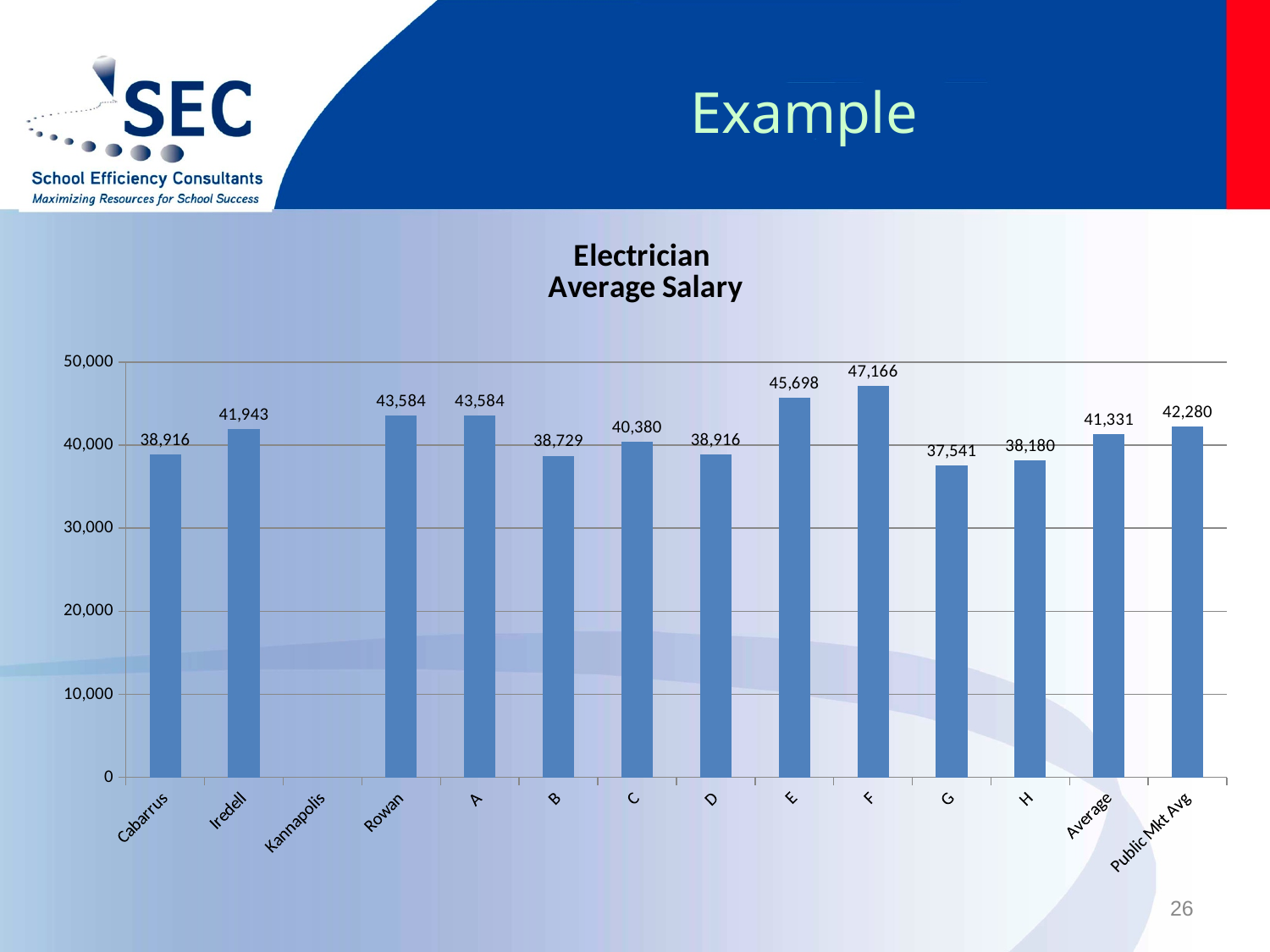
Which is larger, the value for Iredell or the value for Cabarrus? Iredell How many category labels appear on the x axis? 14 What kind of chart is shown on the slide? Bar chart What is the average salary shown for Iredell? 41,943 Which category has the highest average salary? F What is the difference between the Public Mkt Avg and the Average values? 949 What is the title of the chart? Electrician Average Salary What is the value shown for the Average bar? 41,331 What is the difference between the values for F and G? 9,625 Is the value for E greater or less than 40,000? greater Which category has the lowest plotted average salary? G What is the value shown for Public Mkt Avg? 42,280